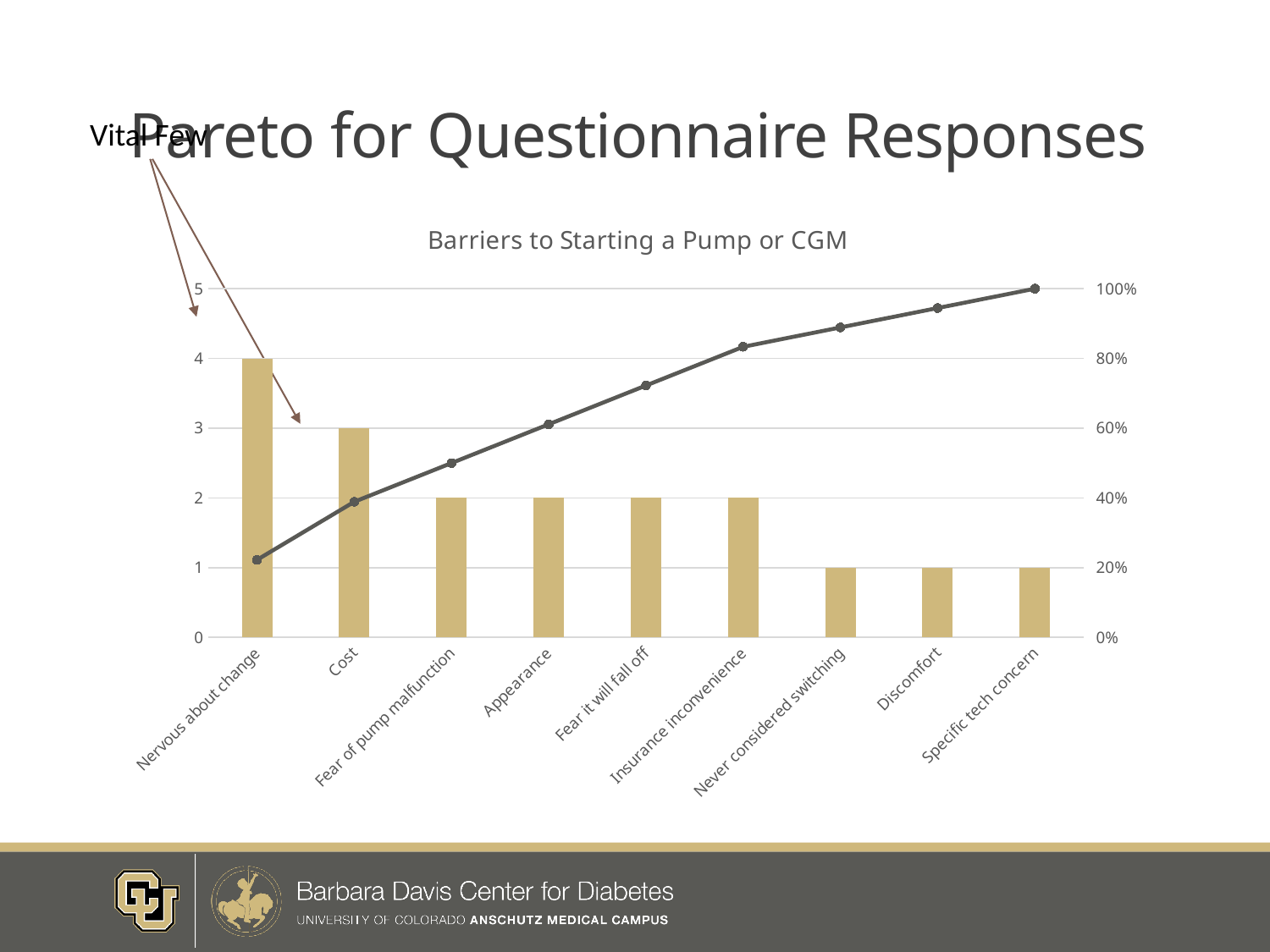
Which category has the highest bar? Nervous about change How many categories are shown on the x axis? 9 What is the title of the chart? Barriers to Starting a Pump or CGM What cumulative percentage does the line reach at Specific tech concern? 100% What is the value of the bar for Cost? 3 Which bar is larger, Insurance inconvenience or Never considered switching? Insurance inconvenience What is the difference between the bars for Nervous about change and Cost? 1 What is the value of the bar for Nervous about change? 4 What is the value of the bar for Discomfort? 1 Do the bar values rise or fall from left to right along the x axis? fall What is the value of the bar for Appearance? 2